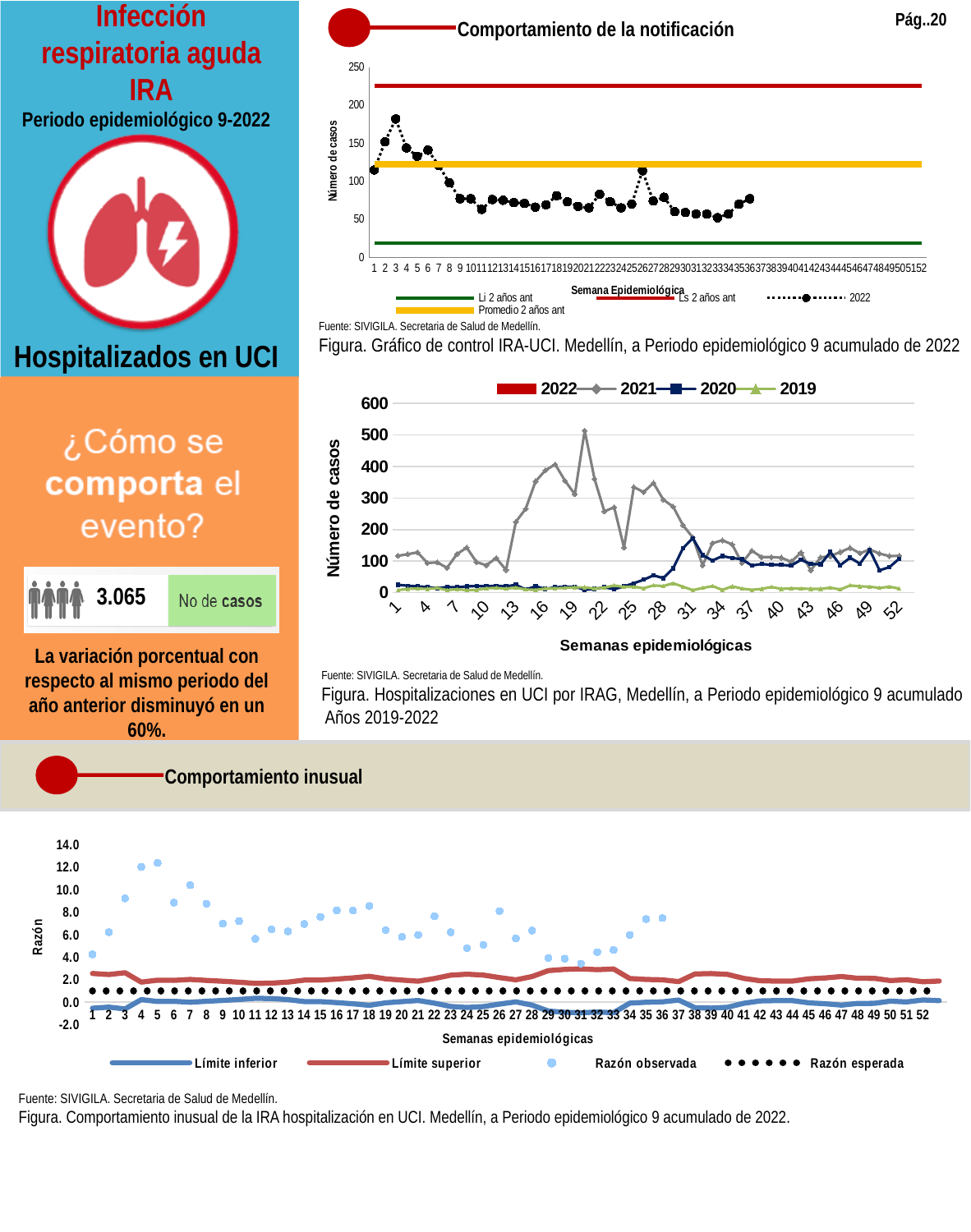
In the chart titled 'Gráfico de control IRA-UCI', is the 2022 value at week 3 greater or less than 150? greater In the chart titled 'Hospitalizaciones en UCI por IRAG', how many series does the legend list? 4 In the chart titled 'Hospitalizaciones en UCI por IRAG', at which epidemiological week does the 2021 series reach its highest value? 20 In the chart titled 'Gráfico de control IRA-UCI', what kind of chart is used to show the data? line chart In the chart titled 'Hospitalizaciones en UCI por IRAG', is the peak value of the 2021 series greater or less than 400? greater In the chart titled 'Hospitalizaciones en UCI por IRAG', which year series reaches the highest peak? 2021 In the chart titled 'Gráfico de control IRA-UCI', is the 'Ls 2 años ant' line greater or less than 200? greater In the chart titled 'Comportamiento inusual de la IRA hospitalización en UCI', how many series does the legend list? 4 In the chart titled 'Gráfico de control IRA-UCI', how many series does the legend list? 4 In the chart titled 'Hospitalizaciones en UCI por IRAG', what is the label of the x axis? Semanas epidemiológicas